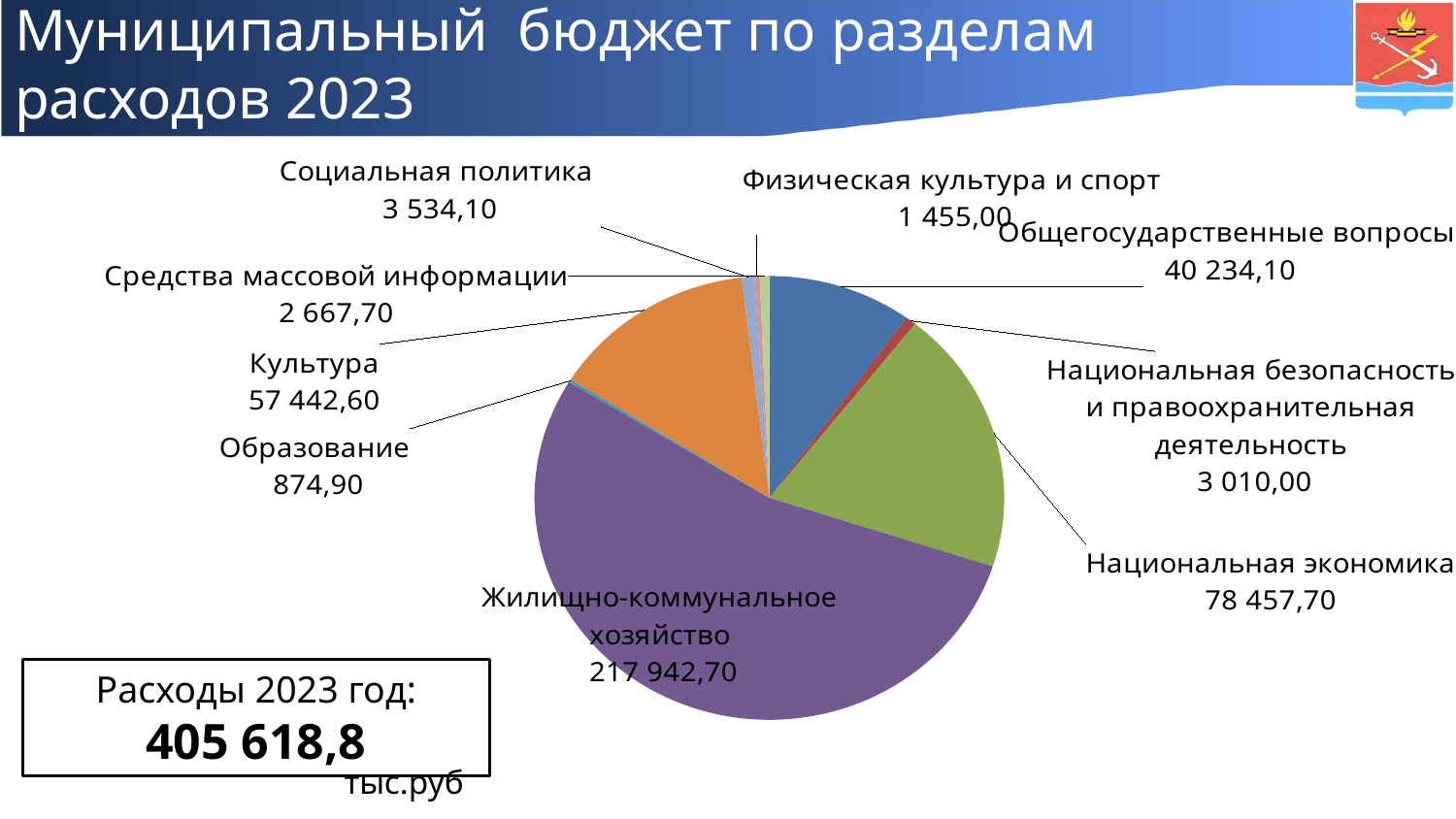
What kind of chart is shown on the slide? pie chart What is the value for Национальная экономика? 78 457,70 What total expenditure for 2023 is shown in the box on the slide? 405 618,8 тыс.руб What is the value for Образование? 874,90 What is the difference between Национальная экономика and Культура? 21 015,10 What is the value for Жилищно-коммунальное хозяйство? 217 942,70 How many categories (slices) does the pie chart show? 9 What is the title of the slide? Муниципальный бюджет по разделам расходов 2023 What is the value for Общегосударственные вопросы? 40 234,10 Which category has the largest slice of the pie? Жилищно-коммунальное хозяйство Which is larger: Культура or Национальная экономика? Национальная экономика Which category has the smallest value? Образование